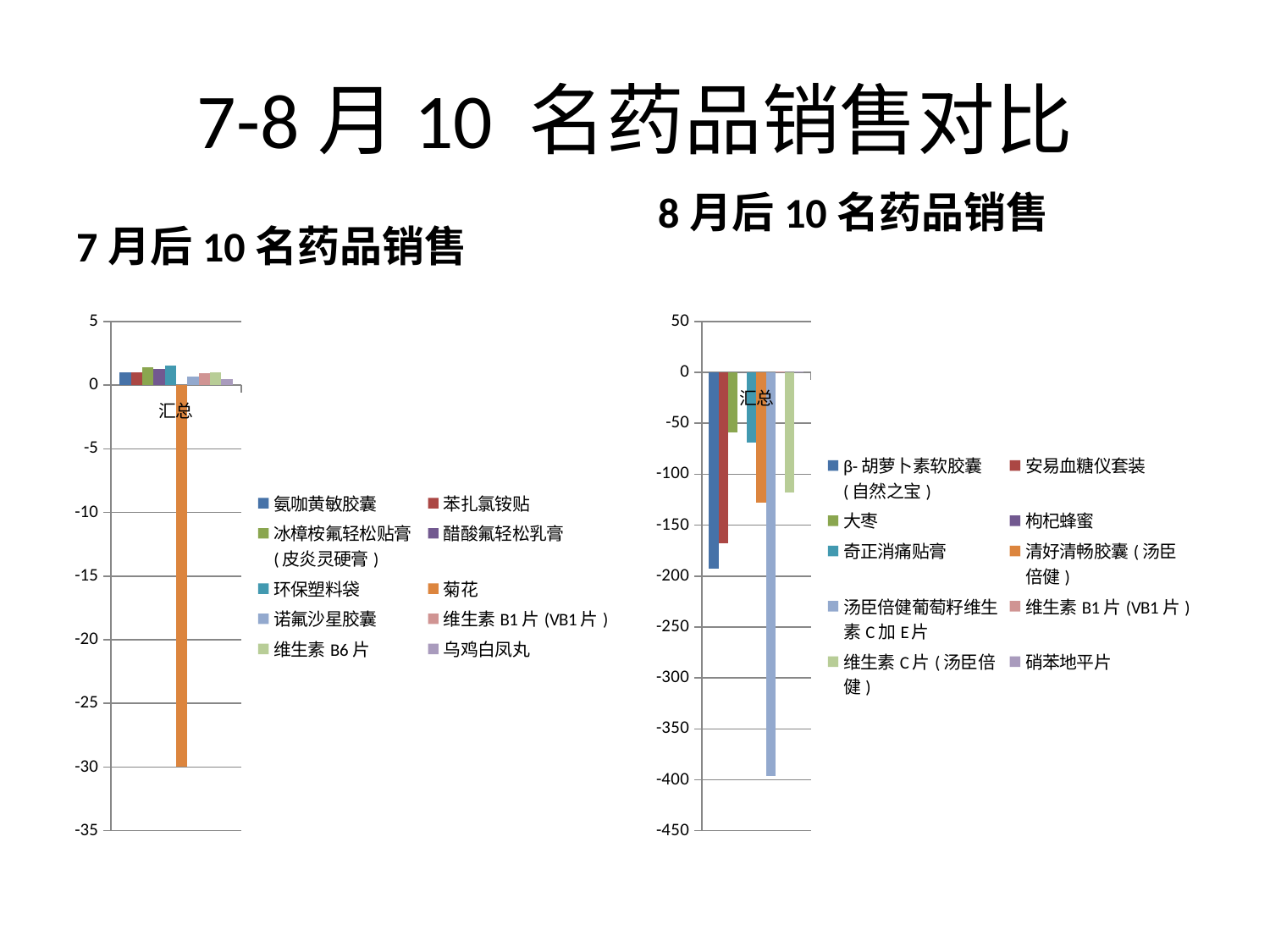
In the left chart (7月后10名药品销售), how many series does the legend list? 10 In the right chart (8月后10名药品销售), which is larger, the value for β-胡萝卜素软胶囊（自然之宝） or the value for 安易血糖仪套装? 安易血糖仪套装 In the left chart (7月后10名药品销售), how many categories are shown on the x axis? 1 What is the title of the chart on the right side of the slide? 8月后10名药品销售 In the right chart (8月后10名药品销售), is the value for 大枣 greater or less than -100? greater In the left chart (7月后10名药品销售), which series has the lowest value? 菊花 In the right chart (8月后10名药品销售), is the value for β-胡萝卜素软胶囊（自然之宝） greater or less than -150? less In the left chart (7月后10名药品销售), what is the value for 菊花? -30 In the right chart (8月后10名药品销售), which series has the lowest value? 汤臣倍健葡萄籽维生素C加E片 In the right chart (8月后10名药品销售), is the value for 汤臣倍健葡萄籽维生素C加E片 greater or less than -350? less In the right chart (8月后10名药品销售), how many series does the legend list? 10 What kind of chart is the left chart titled 7月后10名药品销售? bar chart